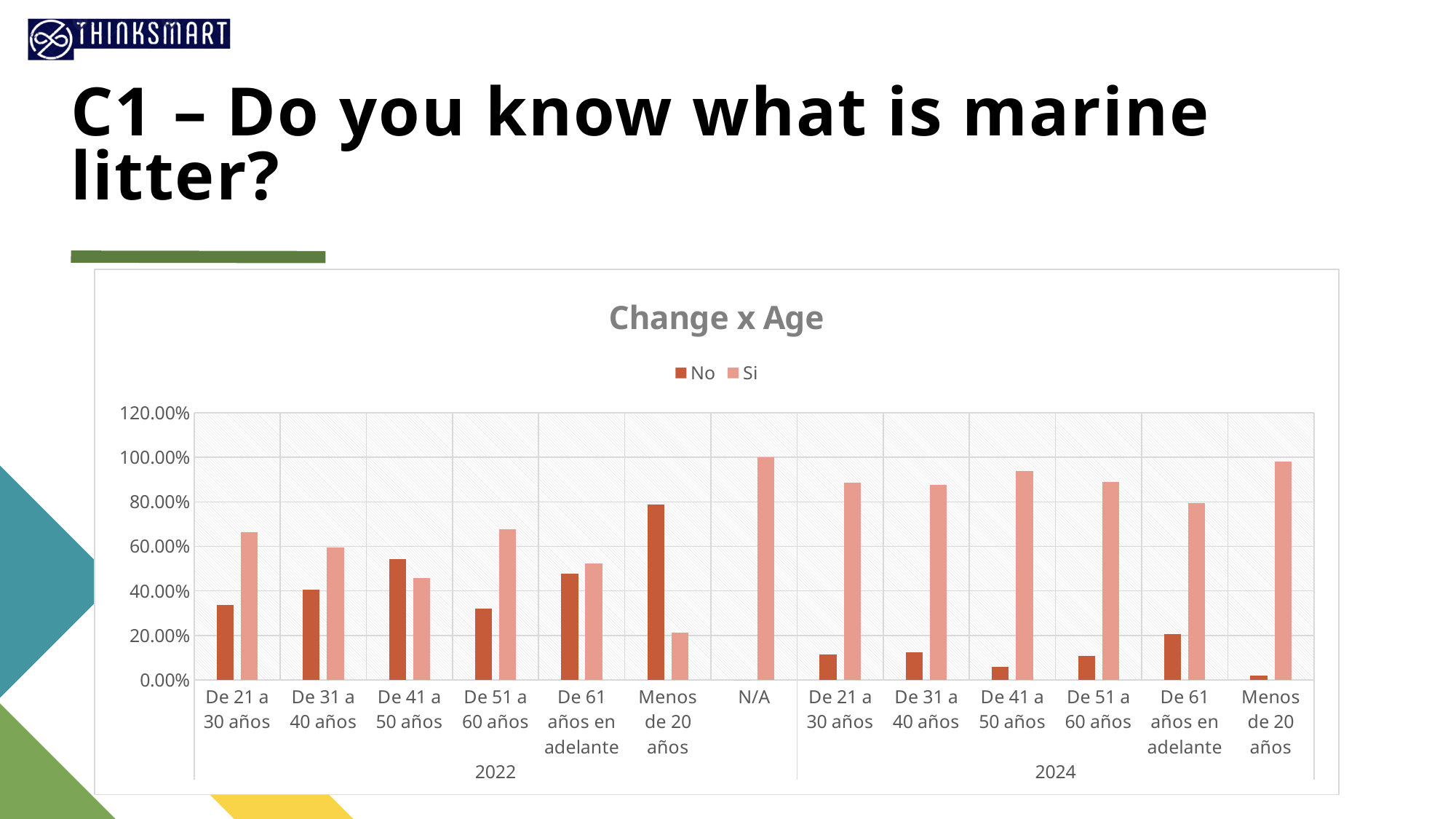
Is the 'Si' value for De 41 a 50 años in 2024 greater or less than 80.00%? greater Which category has the highest 'No' value? Menos de 20 años (2022) What kind of chart is shown on the slide? bar chart What is the 'Si' value for N/A in 2022? 100.00% For De 41 a 50 años in 2022, which is larger, 'No' or 'Si'? No What is the title of the chart? Change x Age Which category has the lowest 'No' value? N/A (2022) What are the two series named in the legend? No and Si Which category has the highest 'Si' value? N/A (2022) How many series does the legend list? 2 How many age categories are plotted along the x axis in total across both years? 13 Is the 'No' value for Menos de 20 años in 2022 greater or less than 60.00%? greater